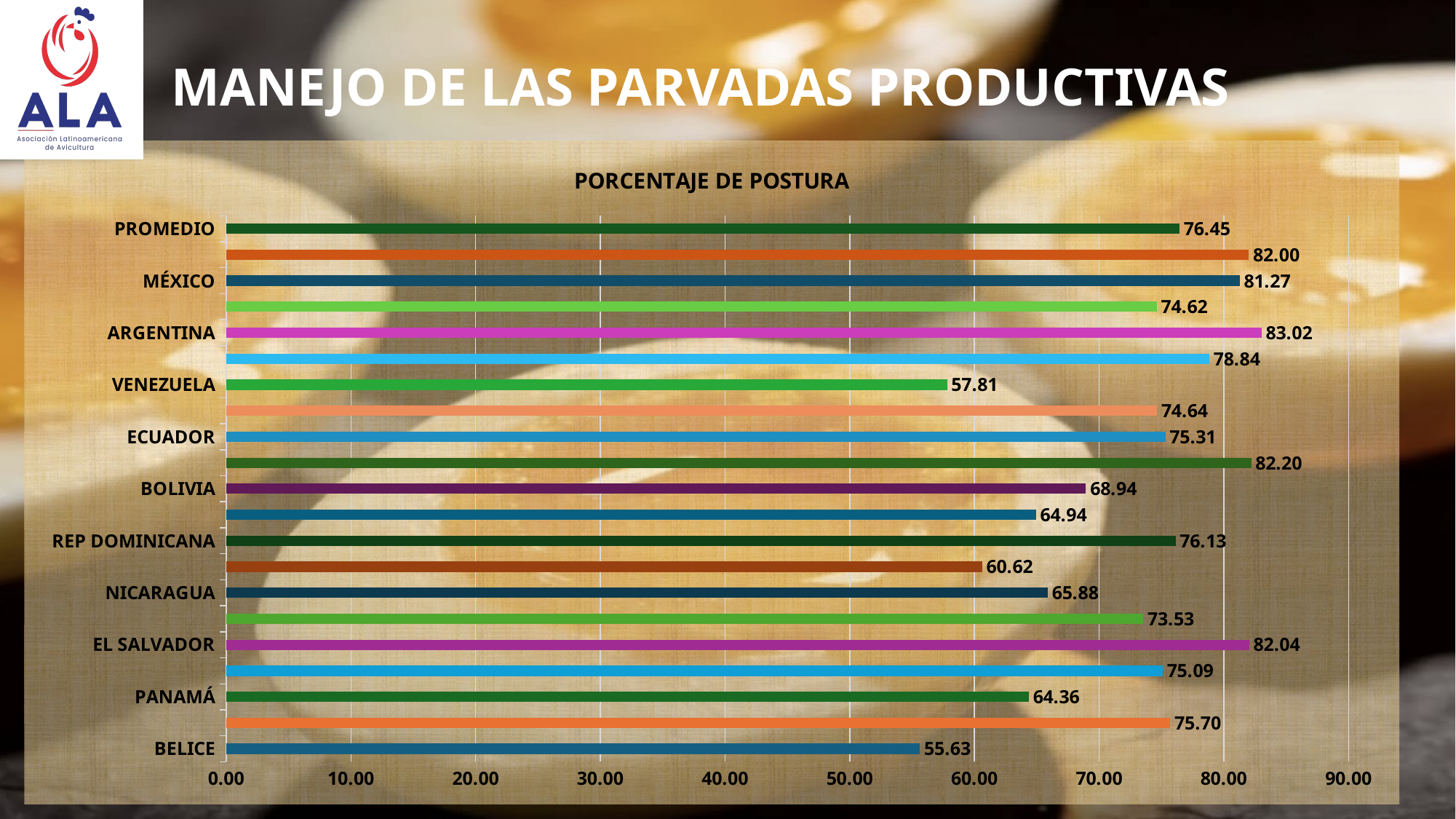
What is the value for PANAMÁ? 64.36 What is the value for ARGENTINA? 83.02 Which is larger, the value for EL SALVADOR or the value for MÉXICO? EL SALVADOR What is the value for NICARAGUA? 65.88 Which labeled category has the lowest value? BELICE What is the value for BELICE? 55.63 What is the value for PROMEDIO? 76.45 What is the difference between the values for MÉXICO and ECUADOR? 5.96 What kind of chart is shown on the slide? bar chart Which labeled category has the highest value? ARGENTINA What is the difference between the values for PROMEDIO and BOLIVIA? 7.51 Is the value for VENEZUELA greater or less than 60.00? less